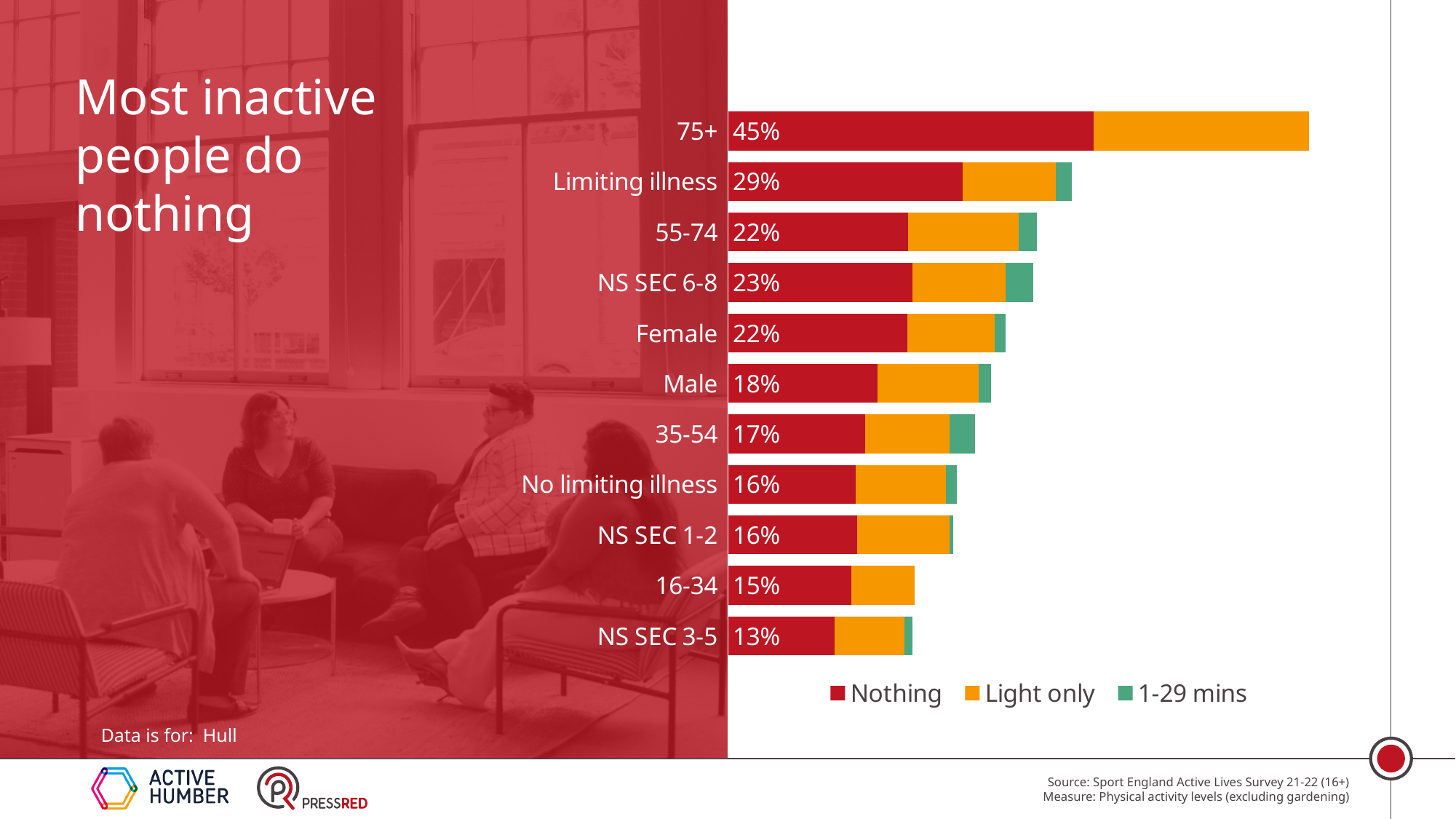
Which category has the lowest 'Nothing' value? NS SEC 3-5 Which category has the highest 'Nothing' value? 75+ Which has a higher 'Nothing' value, Female or Male? Female How many categories are shown on the chart? 11 What kind of chart is shown on the slide? Stacked bar chart What is the 'Nothing' value for the Limiting illness group? 29% What is the 'Nothing' value for NS SEC 6-8? 23% Which series is shown in orange in the legend? Light only What percentage of people aged 75+ do nothing? 45% How many percentage points higher is the 'Nothing' value for 75+ than for Limiting illness? 16 percentage points How many series does the legend list? 3 What percentage of Males do nothing? 18%